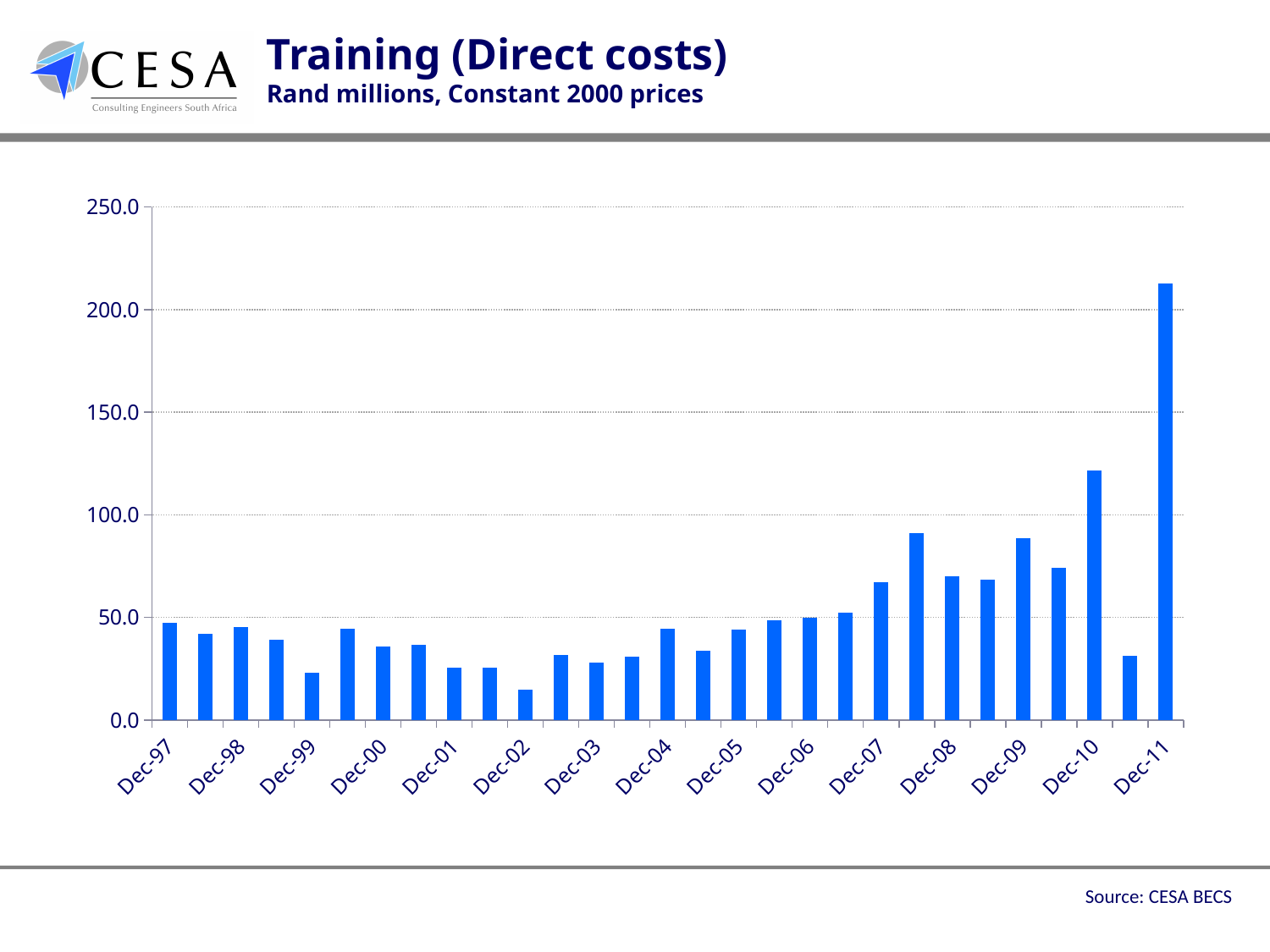
In what units are the values on the chart expressed, according to the subtitle? Rand millions, Constant 2000 prices Which is larger, the value for Dec-07 or the value for Dec-02? Dec-07 Is the value for Dec-10 greater or less than 100.0? greater Is the value for Dec-02 greater or less than 50.0? less How many period labels are shown on the x axis? 15 Is the value for Dec-09 greater or less than 100.0? less Which labelled period has the lowest value on the chart? Dec-02 What kind of chart is shown on the slide? bar chart Which is larger, the value for Dec-10 or the value for Dec-09? Dec-10 What is the title of the chart on the slide? Training (Direct costs) Which labelled period has the highest value on the chart? Dec-11